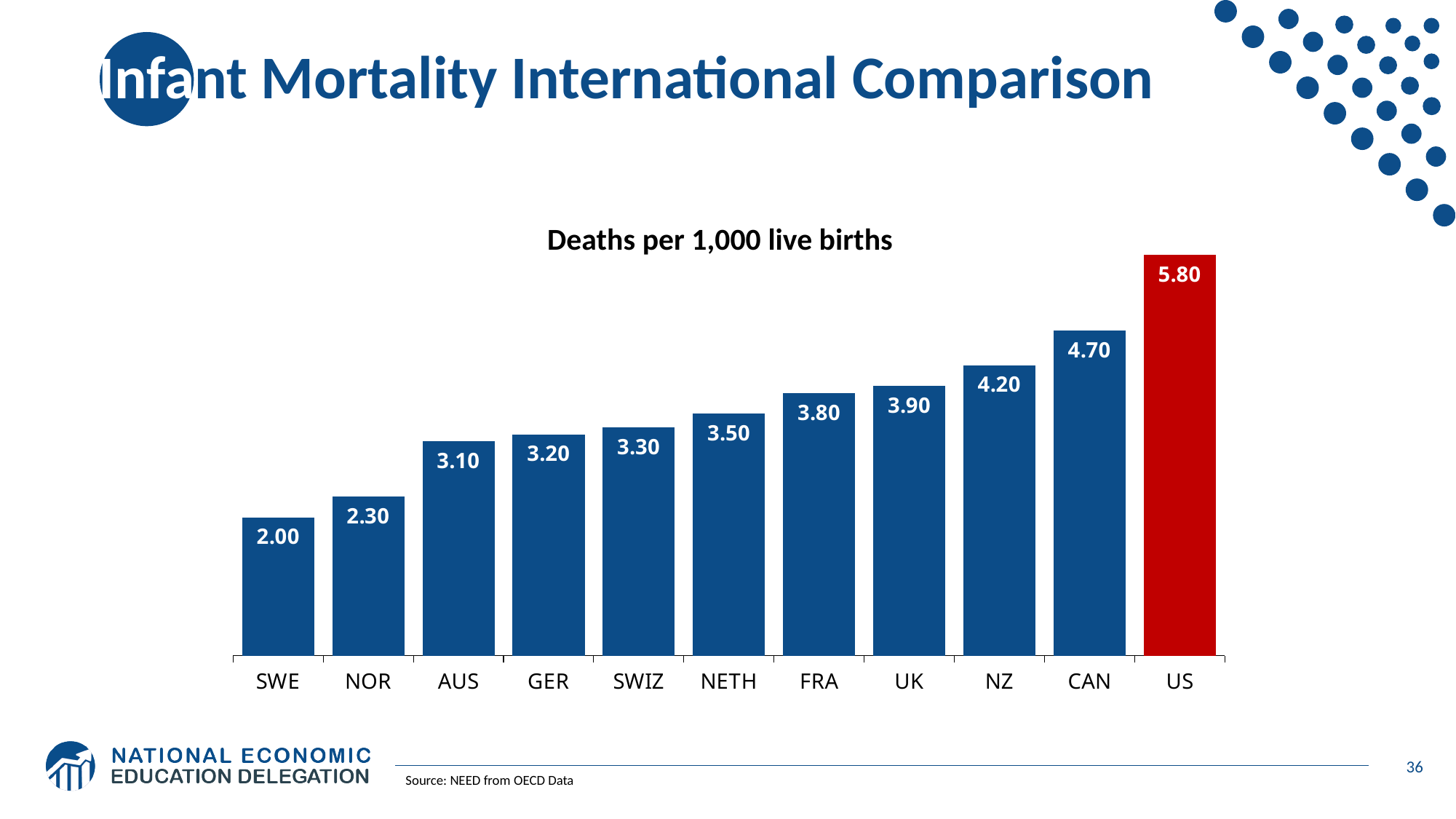
What is the difference between the values for the US and CAN? 1.10 Which bar is coloured red rather than blue? US Which country has the lowest value? SWE How many countries are shown in the chart? 11 What is the difference between the values for FRA and SWE? 1.80 Which is larger, the value for NETH or the value for NOR? NETH What is the value for NZ? 4.20 What is the value for the US? 5.80 Which country has the highest value? US What is the value for GER? 3.20 Do the values rise or fall from left to right along the x axis? Rise What kind of chart is this? Bar chart